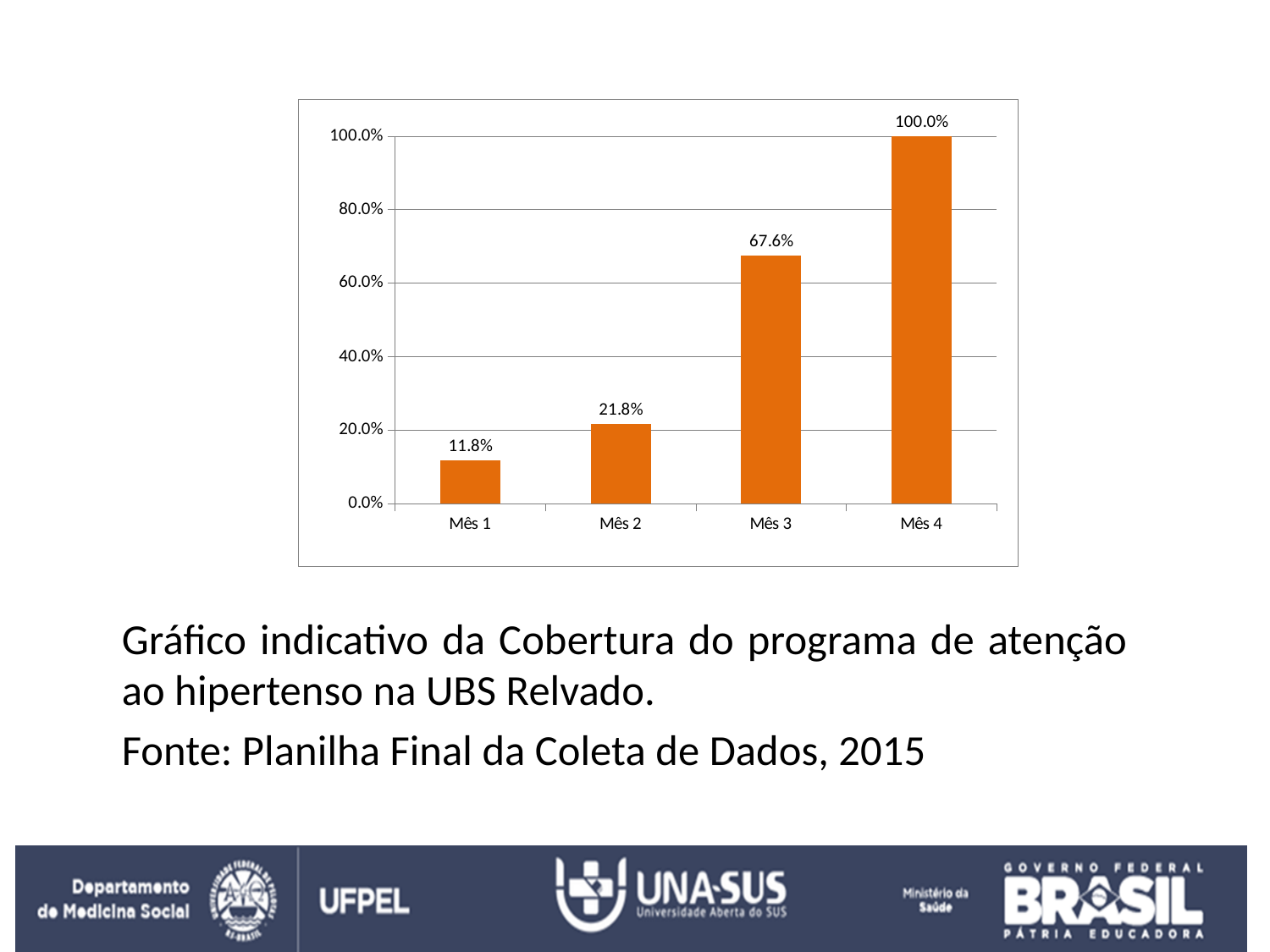
How many months are shown on the x axis? 4 Which month has the highest value? Mês 4 Is the value for Mês 3 greater or less than 60.0%? greater What is the value for Mês 2? 21.8% What is the value for Mês 3? 67.6% Which is larger, the value for Mês 2 or the value for Mês 3? Mês 3 What is the value for Mês 1? 11.8% What kind of chart is shown on the slide? bar chart Which month has the lowest value? Mês 1 What is the value for Mês 4? 100.0% Do the values rise or fall from Mês 1 to Mês 4? rise What is the difference between the values for Mês 3 and Mês 2? 45.8%